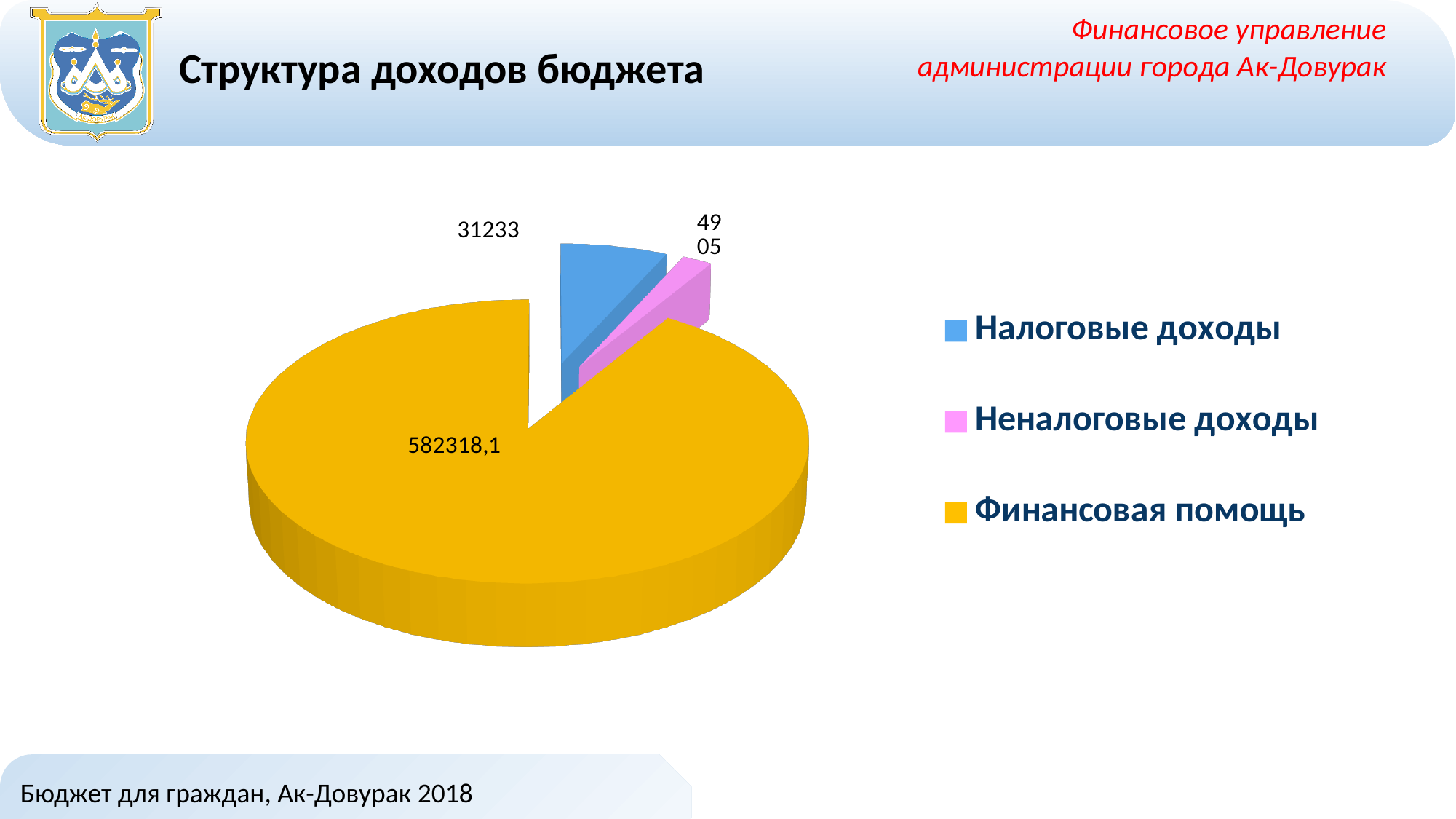
What colour is the slice for Неналоговые доходы? pink What is the difference between the values for Финансовая помощь and Налоговые доходы? 551085,1 How many entries does the legend list? 3 Which is larger, Финансовая помощь or Налоговые доходы? Финансовая помощь Which category has the smallest slice of the pie? Неналоговые доходы How many slices does the pie chart have? 3 What is the title of the chart on the slide? Структура доходов бюджета What is the value for Финансовая помощь? 582318,1 What is the value for Налоговые доходы? 31233 Which category has the largest slice of the pie? Финансовая помощь What kind of chart is shown on the slide? pie chart Which is larger, Налоговые доходы or Неналоговые доходы? Налоговые доходы